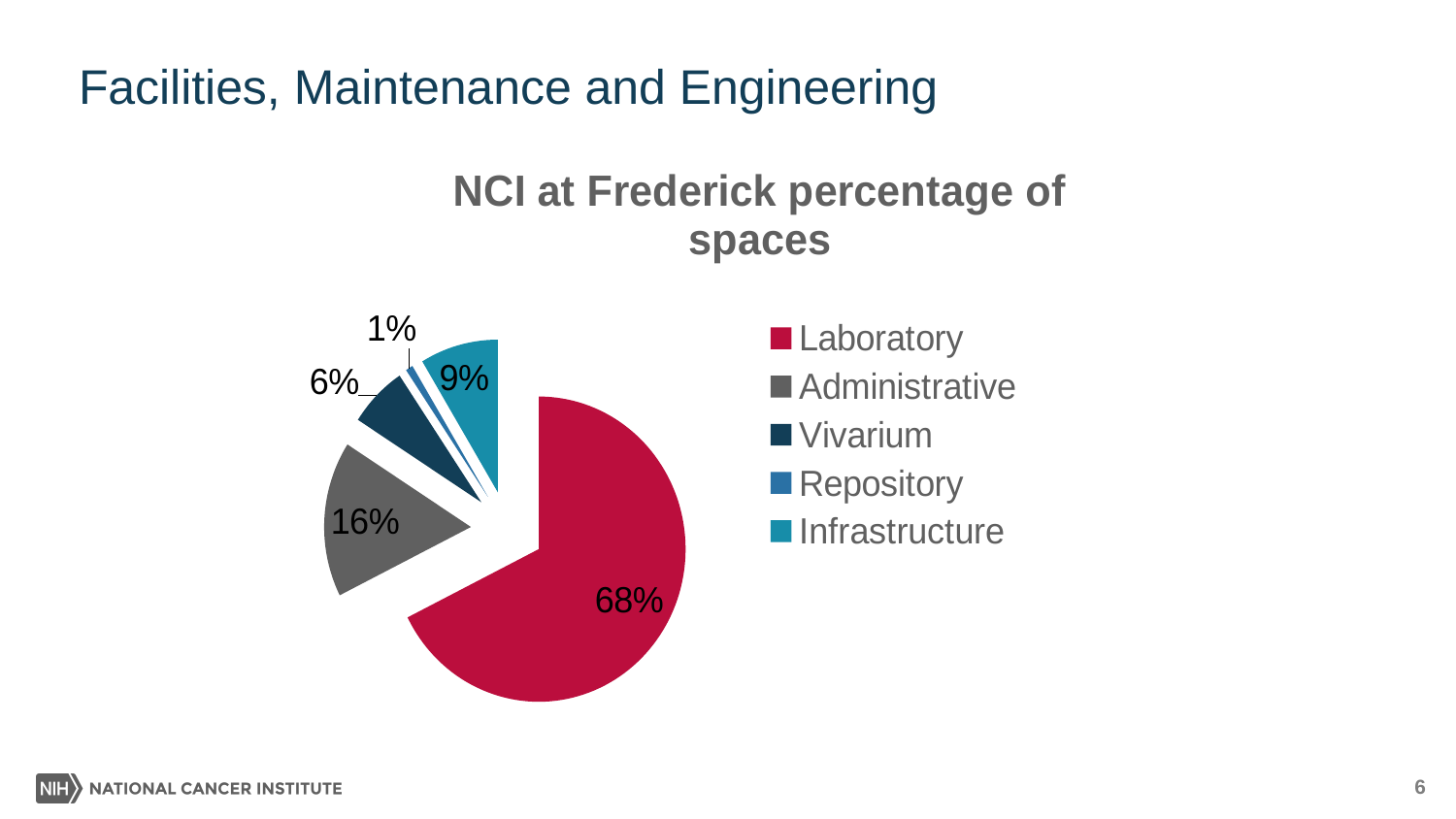
How many categories are shown in the pie chart? 5 What is the difference in percentage points between Laboratory and Administrative? 52 Which category has the smallest share of spaces? Repository What percentage of spaces is Repository? 1% What percentage of spaces is Laboratory? 68% What percentage of spaces is Infrastructure? 9% What percentage of spaces is Vivarium? 6% What kind of chart is shown on the slide? Pie chart Which category has the largest share of spaces? Laboratory What percentage of spaces is Administrative? 16% Which has a larger share of spaces, Infrastructure or Vivarium? Infrastructure What is the title of the chart? NCI at Frederick percentage of spaces